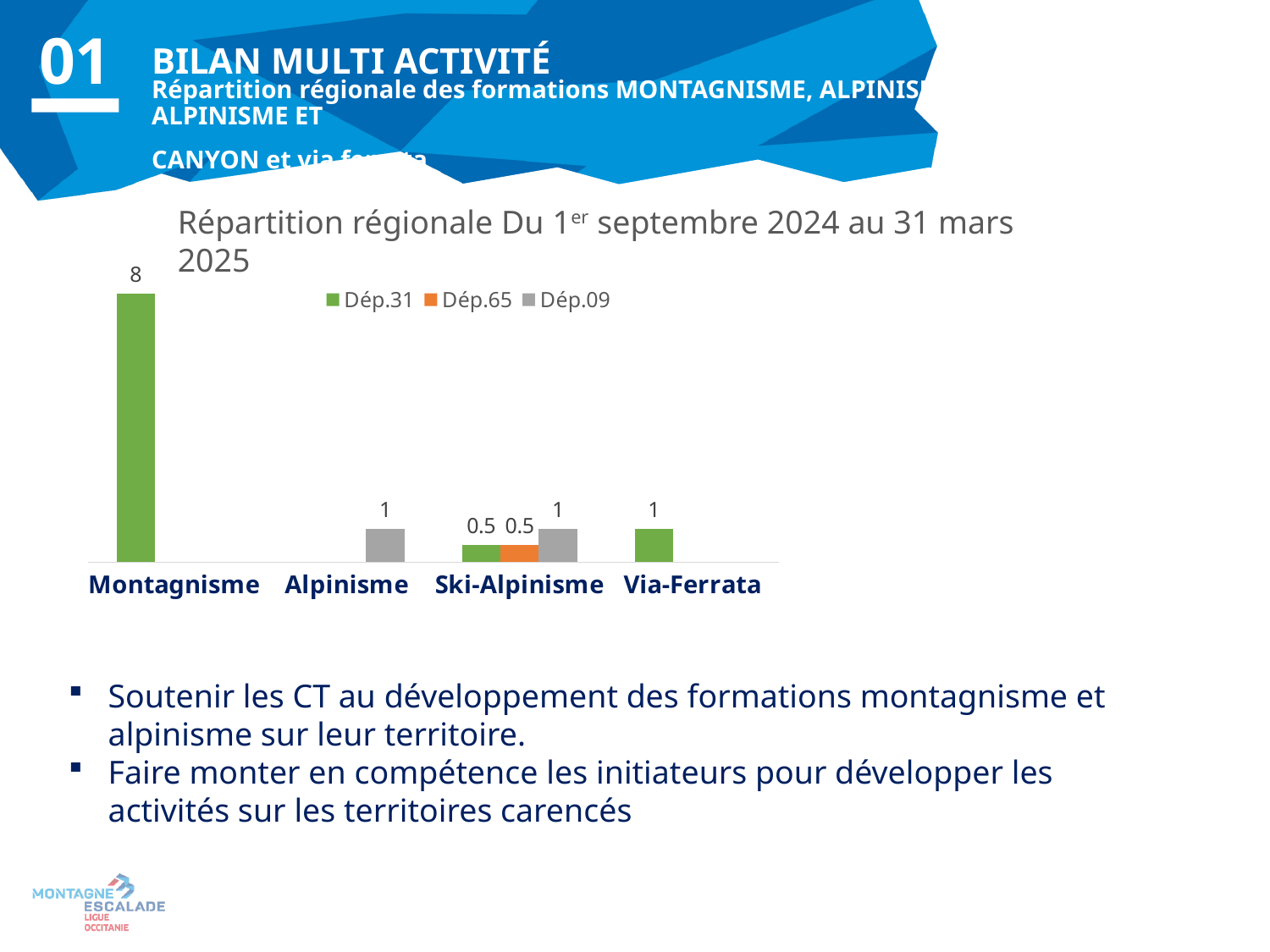
Which series is shown in orange in the legend? Dép.65 How many categories are shown on the x axis? 4 What kind of chart is shown on the slide? Bar chart What is the value for Dép.09 in the Ski-Alpinisme category? 1 What is the value for Dép.65 in the Ski-Alpinisme category? 0.5 What is the difference between the Dép.31 value for Montagnisme and the Dép.31 value for Via-Ferrata? 7 Which category has the highest value for Dép.31? Montagnisme What is the value for Dép.09 in the Alpinisme category? 1 How many series does the legend list? 3 What is the value for Dép.31 in the Via-Ferrata category? 1 Which is larger in the Ski-Alpinisme category: the Dép.09 value or the Dép.65 value? Dép.09 What is the value for Dép.31 in the Montagnisme category? 8